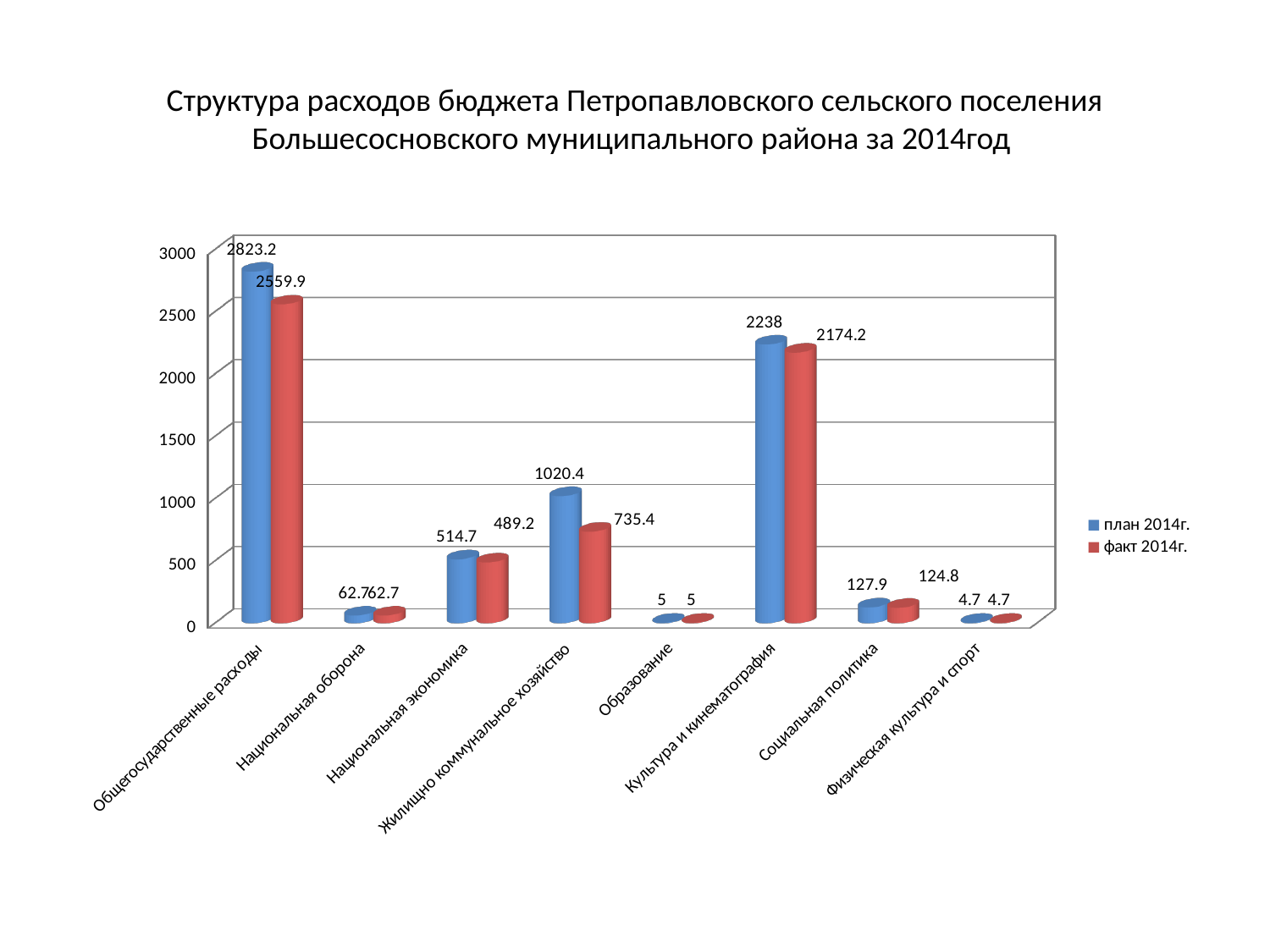
How many categories are shown on the x axis? 8 What kind of chart is shown on the slide? bar chart What is the план 2014г. value for Социальная политика? 127.9 What is the план 2014г. value for Общегосударственные расходы? 2823.2 Which is larger for Национальная экономика: the план 2014г. value or the факт 2014г. value? план 2014г. What colour represents the факт 2014г. series? red What is the факт 2014г. value for Жилищно коммунальное хозяйство? 735.4 Which category has the lowest факт 2014г. value? Физическая культура и спорт How many series does the legend list? 2 Which category has the highest план 2014г. value? Общегосударственные расходы What is the difference between the план 2014г. and факт 2014г. values for Жилищно коммунальное хозяйство? 285 What is the факт 2014г. value for Культура и кинематография? 2174.2